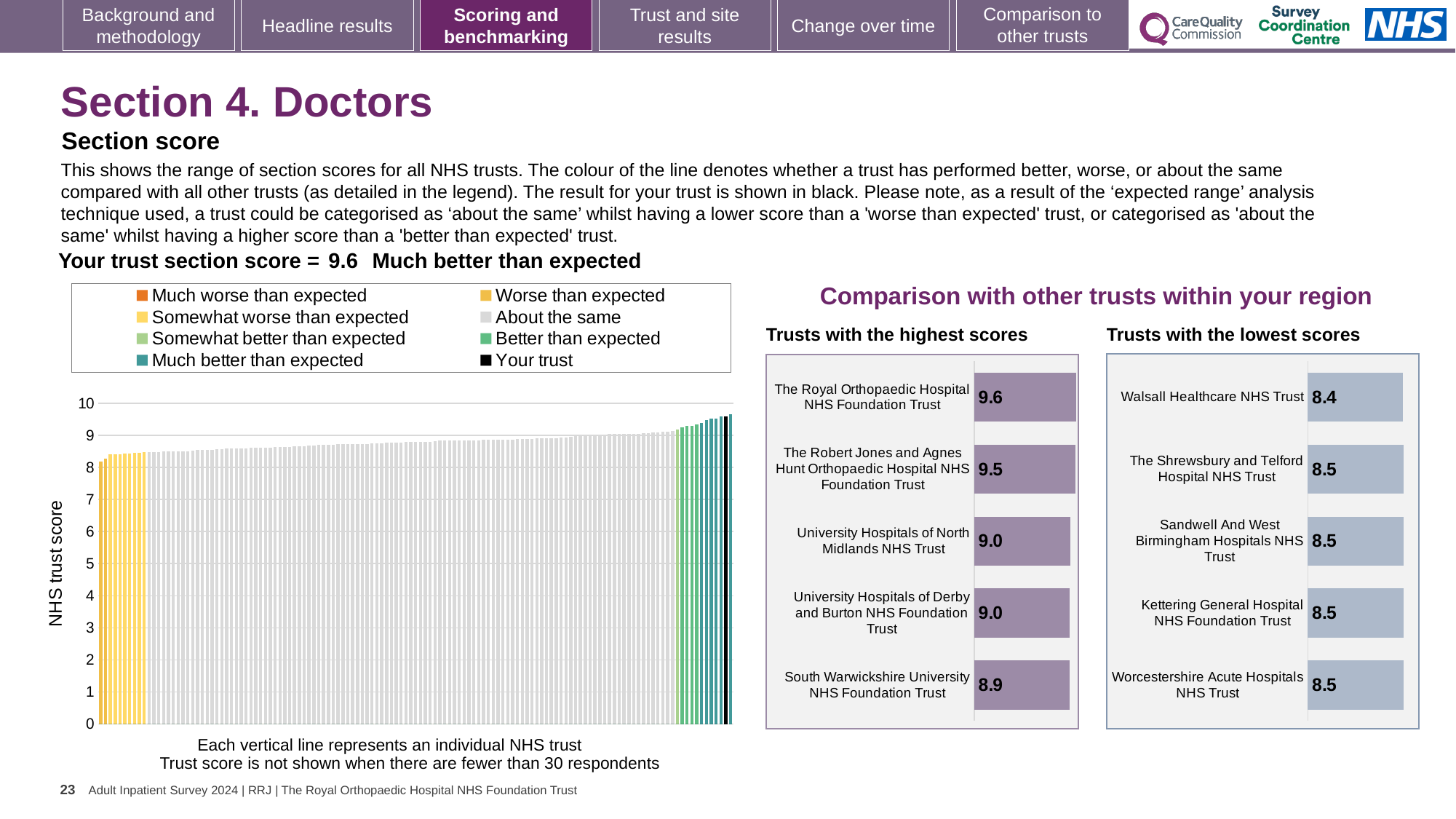
In the 'Trusts with the highest scores' chart, how many trusts are shown? 5 In the main 'NHS trust score' chart, do the trust scores rise or fall from left to right? Rise Which is larger: the score for The Robert Jones and Agnes Hunt Orthopaedic Hospital NHS Foundation Trust in the highest scores chart, or the score for Kettering General Hospital NHS Foundation Trust in the lowest scores chart? The Robert Jones and Agnes Hunt Orthopaedic Hospital NHS Foundation Trust In the 'Trusts with the lowest scores' chart, what is the score for Worcestershire Acute Hospitals NHS Trust? 8.5 In the 'Trusts with the highest scores' chart, what is the difference between the scores of The Royal Orthopaedic Hospital NHS Foundation Trust and South Warwickshire University NHS Foundation Trust? 0.7 In the 'Trusts with the highest scores' chart, what is the score for University Hospitals of North Midlands NHS Trust? 9.0 In the main 'NHS trust score' chart, what kind of chart is used? Bar chart In the 'Trusts with the lowest scores' chart, what is the score for Walsall Healthcare NHS Trust? 8.4 In the 'Trusts with the highest scores' chart, which trust has the lowest score? South Warwickshire University NHS Foundation Trust In the 'Trusts with the highest scores' chart, what is the score for The Royal Orthopaedic Hospital NHS Foundation Trust? 9.6 In the 'Trusts with the lowest scores' chart, which trust has the lowest score? Walsall Healthcare NHS Trust How many entries does the legend of the main 'NHS trust score' chart list? 8